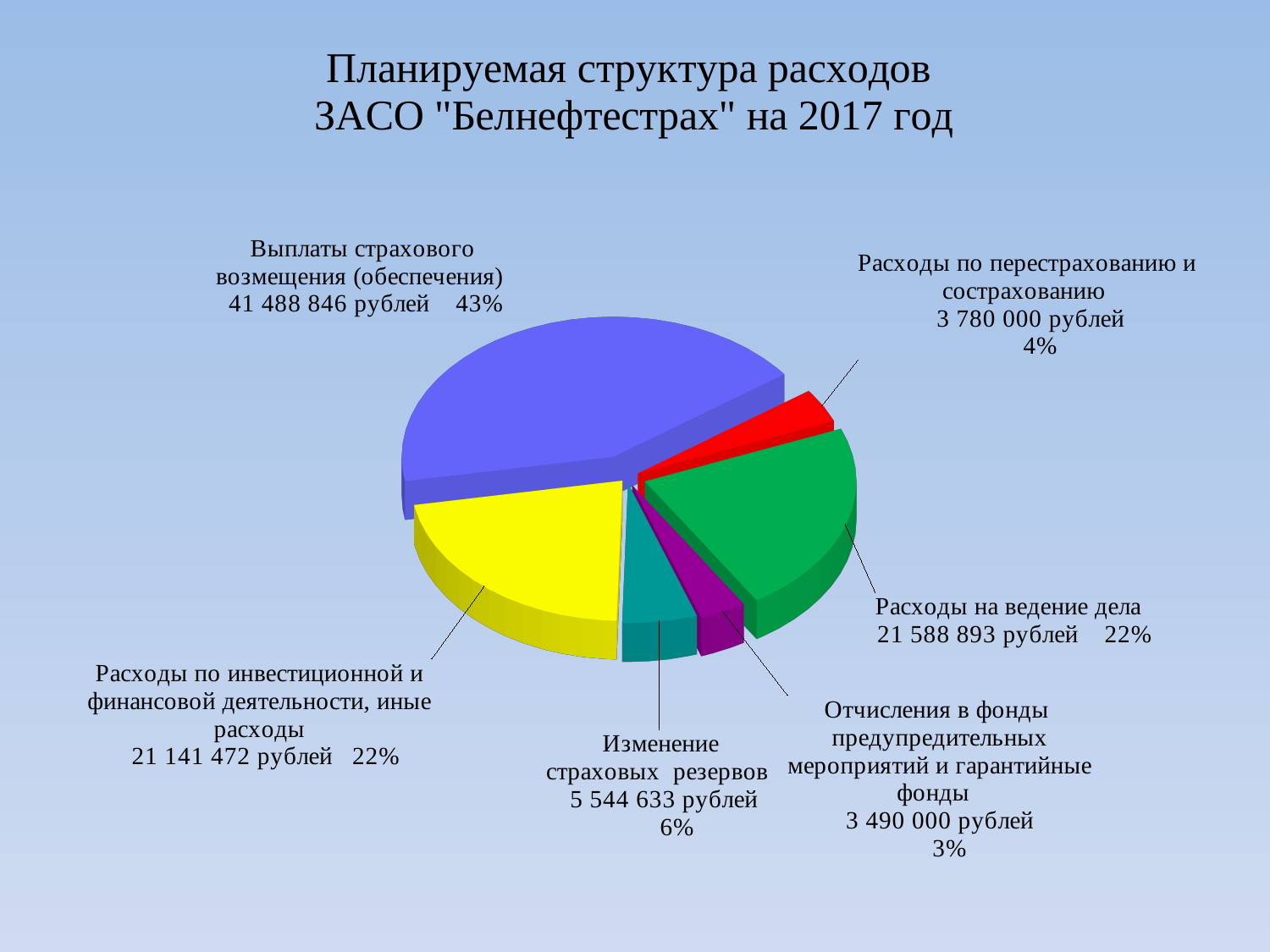
What is the planned amount for "Выплаты страхового возмещения (обеспечения)"? 41 488 846 рублей What is the planned amount for "Изменение страховых резервов"? 5 544 633 рублей What is the planned amount for "Расходы на ведение дела"? 21 588 893 рублей What share of the pie does "Отчисления в фонды предупредительных мероприятий и гарантийные фонды" represent? 3% How many categories (slices) does the pie chart have? 6 Which category has the largest share of planned expenses? Выплаты страхового возмещения (обеспечения) What is the difference in rubles between "Расходы на ведение дела" and "Расходы по инвестиционной и финансовой деятельности, иные расходы"? 447 421 рублей What is the title of the chart on the slide? Планируемая структура расходов ЗАСО "Белнефтестрах" на 2017 год Which category has the smallest share of planned expenses? Отчисления в фонды предупредительных мероприятий и гарантийные фонды What type of chart is shown on the slide? Pie chart What share of the pie does "Расходы по перестрахованию и сострахованию" represent? 4% Which is larger in rubles: "Расходы по перестрахованию и сострахованию" or "Отчисления в фонды предупредительных мероприятий и гарантийные фонды"? Расходы по перестрахованию и сострахованию